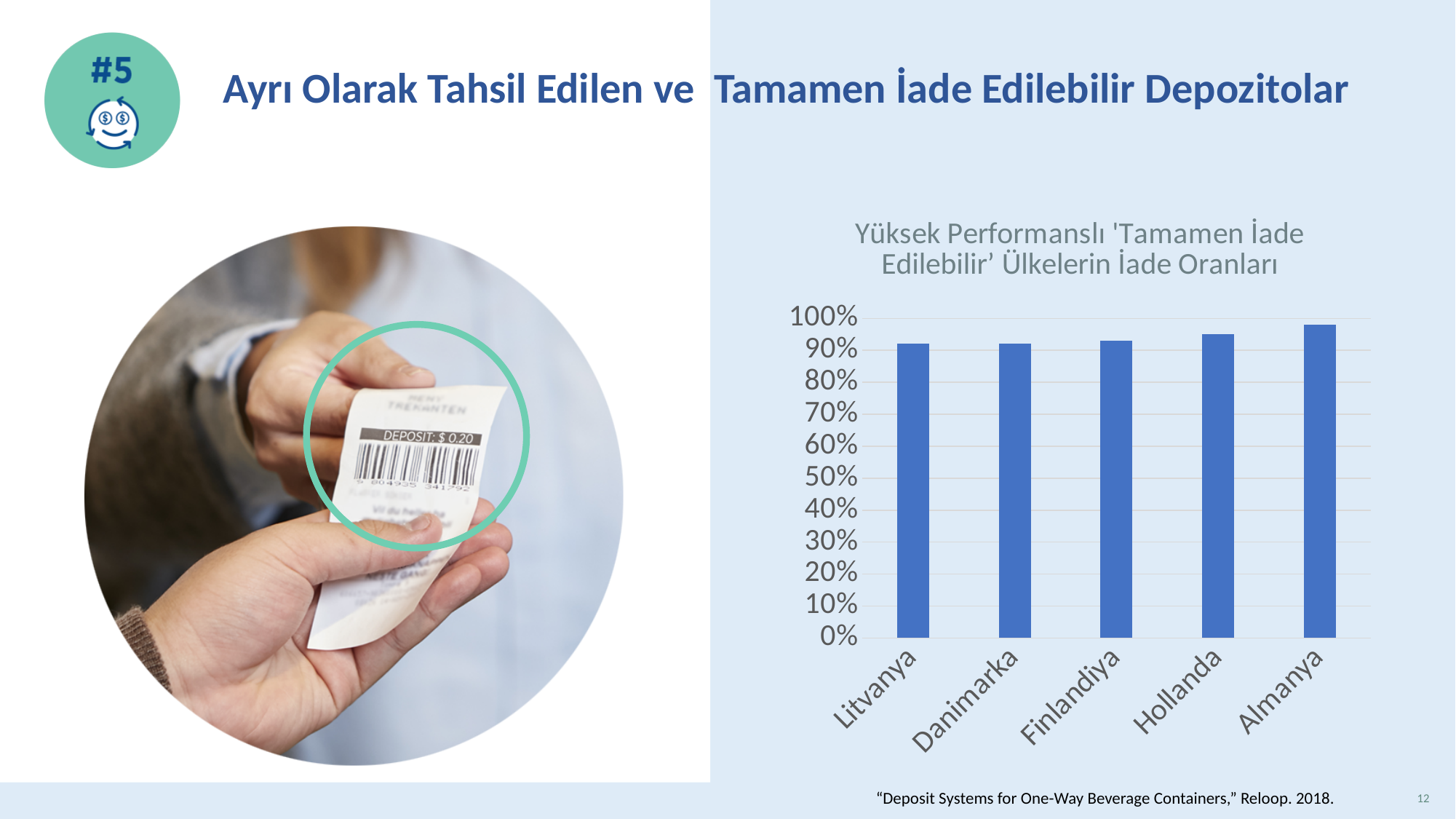
How many countries are shown in the chart? 5 Which country has the highest return rate in the chart? Almanya Do the return rates generally rise or fall from left to right across the countries? rise Which has a higher return rate, Hollanda or Danimarka? Hollanda Is the return rate for Almanya greater or less than 100%? less Is the return rate for Finlandiya greater or less than 80%? greater What colour are the bars in the chart? blue What is the title of the chart? Yüksek Performanslı 'Tamamen İade Edilebilir' Ülkelerin İade Oranları What kind of chart is shown on the slide? bar chart Is the return rate for Almanya greater or less than 90%? greater Which has a higher return rate, Almanya or Litvanya? Almanya